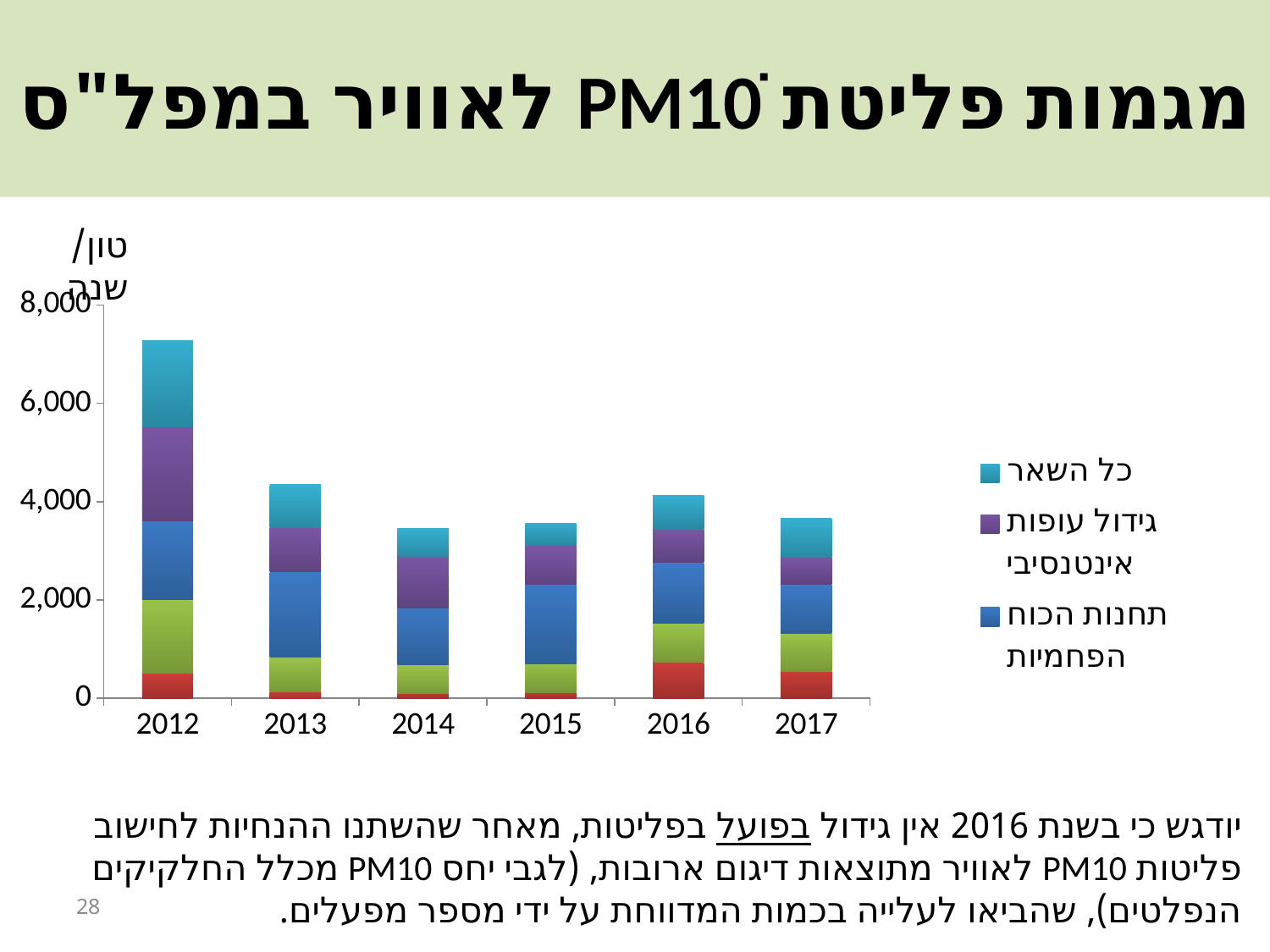
What kind of chart is shown on the slide? bar chart Do the total emissions rise or fall from 2012 to 2014? fall Is the total value for 2013 greater or less than 4,000? greater Which year has the highest total PM10 emissions in the chart? 2012 Which legend entry is listed first (at the top) in the chart's legend? כל השאר Which year has a larger total, 2013 or 2014? 2013 How many years are shown on the x axis of the chart? 6 Is the total value for 2017 greater or less than 4,000? less What unit is written above the y axis of the chart? טון/שנה Is the total value for 2014 greater or less than 4,000? less Which year has a larger total, 2012 or 2013? 2012